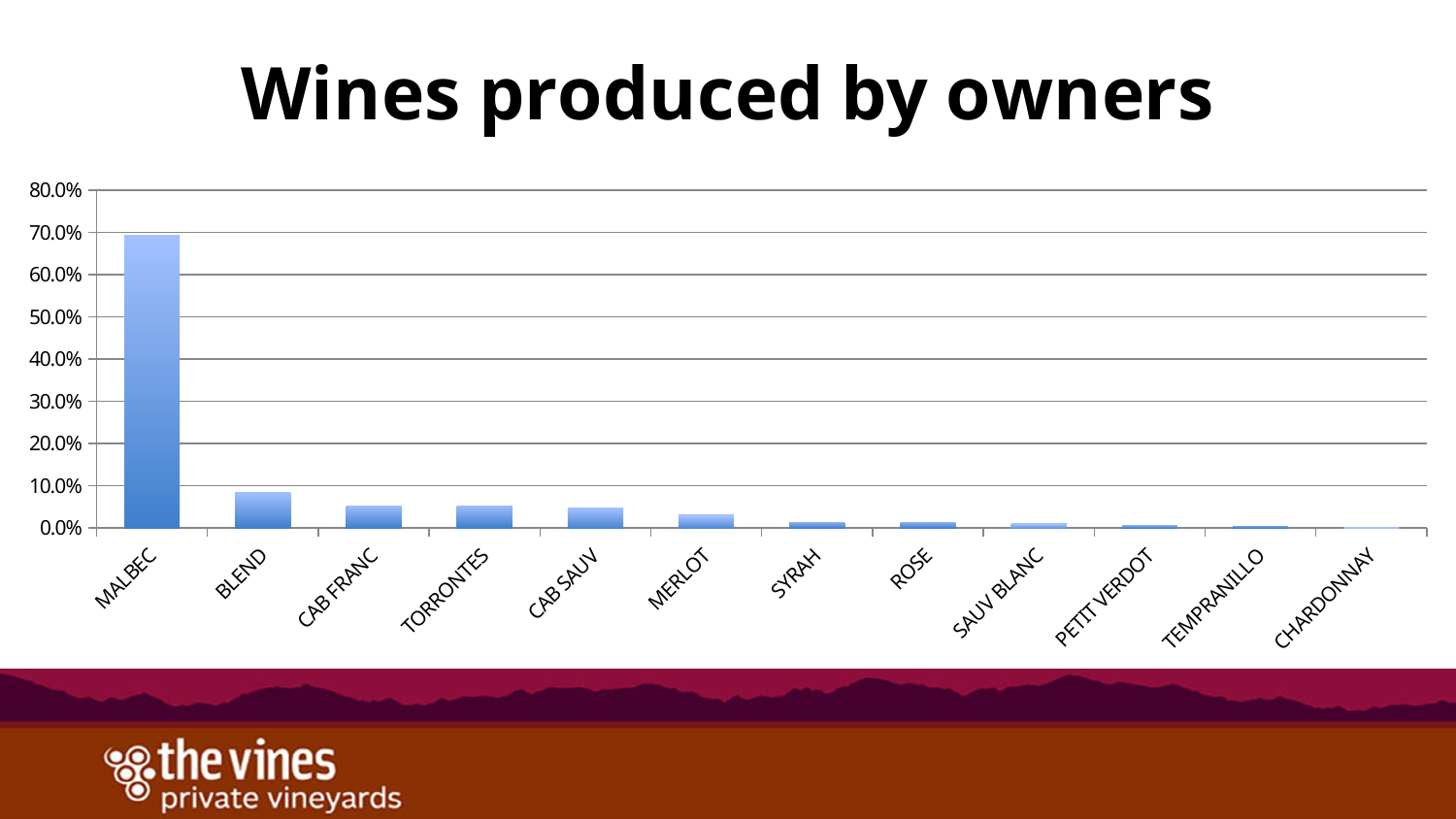
Which is larger, the value for BLEND or the value for MERLOT? BLEND How many wine categories are shown on the x axis? 12 Is the value for MERLOT greater or less than 10.0%? less Which wine has the highest value? MALBEC Which is larger, the value for MALBEC or the value for BLEND? MALBEC What kind of chart is shown on the slide? bar chart Is the value for MALBEC greater or less than 60.0%? greater What is the title of the chart? Wines produced by owners Is the value for BLEND greater or less than 10.0%? less Do the values rise or fall moving from left to right along the x axis? fall Which wine has the lowest value? CHARDONNAY